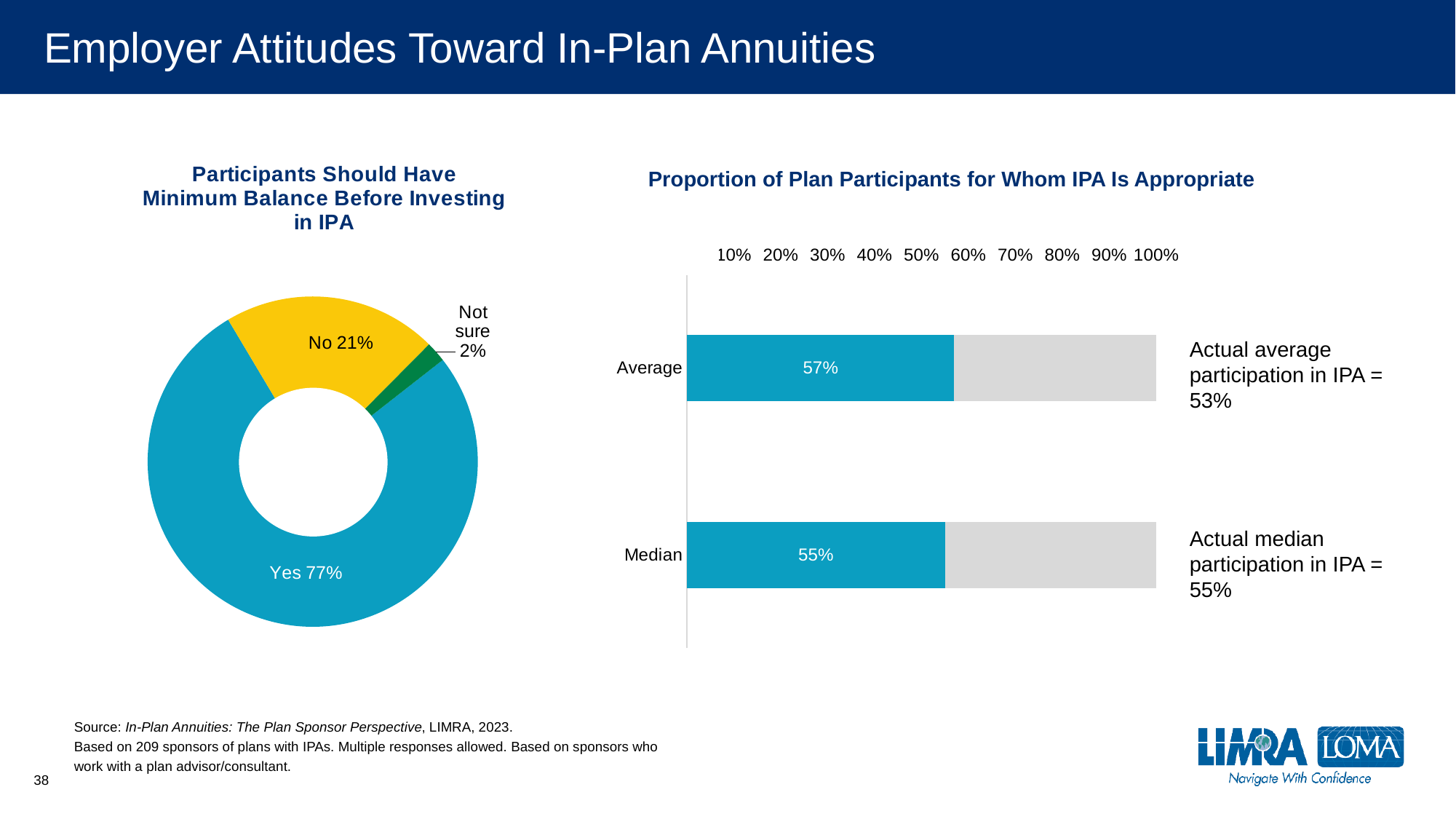
In the 'Participants Should Have Minimum Balance Before Investing in IPA' chart, what percentage answered No? 21% In the 'Proportion of Plan Participants for Whom IPA Is Appropriate' chart, what is the value for Average? 57% In the 'Participants Should Have Minimum Balance Before Investing in IPA' chart, what percentage answered Yes? 77% In the 'Participants Should Have Minimum Balance Before Investing in IPA' chart, which response has the largest share? Yes In the 'Proportion of Plan Participants for Whom IPA Is Appropriate' chart, how many categories are plotted? 2 In the 'Participants Should Have Minimum Balance Before Investing in IPA' chart, what percentage answered Not sure? 2% In the 'Participants Should Have Minimum Balance Before Investing in IPA' chart, how many percentage points larger is Yes than No? 56 What kind of chart is 'Proportion of Plan Participants for Whom IPA Is Appropriate'? Bar chart In the 'Participants Should Have Minimum Balance Before Investing in IPA' chart, which response has the smallest share? Not sure In the 'Proportion of Plan Participants for Whom IPA Is Appropriate' chart, what is the value for Median? 55% What kind of chart is 'Participants Should Have Minimum Balance Before Investing in IPA'? Doughnut (pie) chart In the 'Participants Should Have Minimum Balance Before Investing in IPA' chart, how many response categories are shown? 3